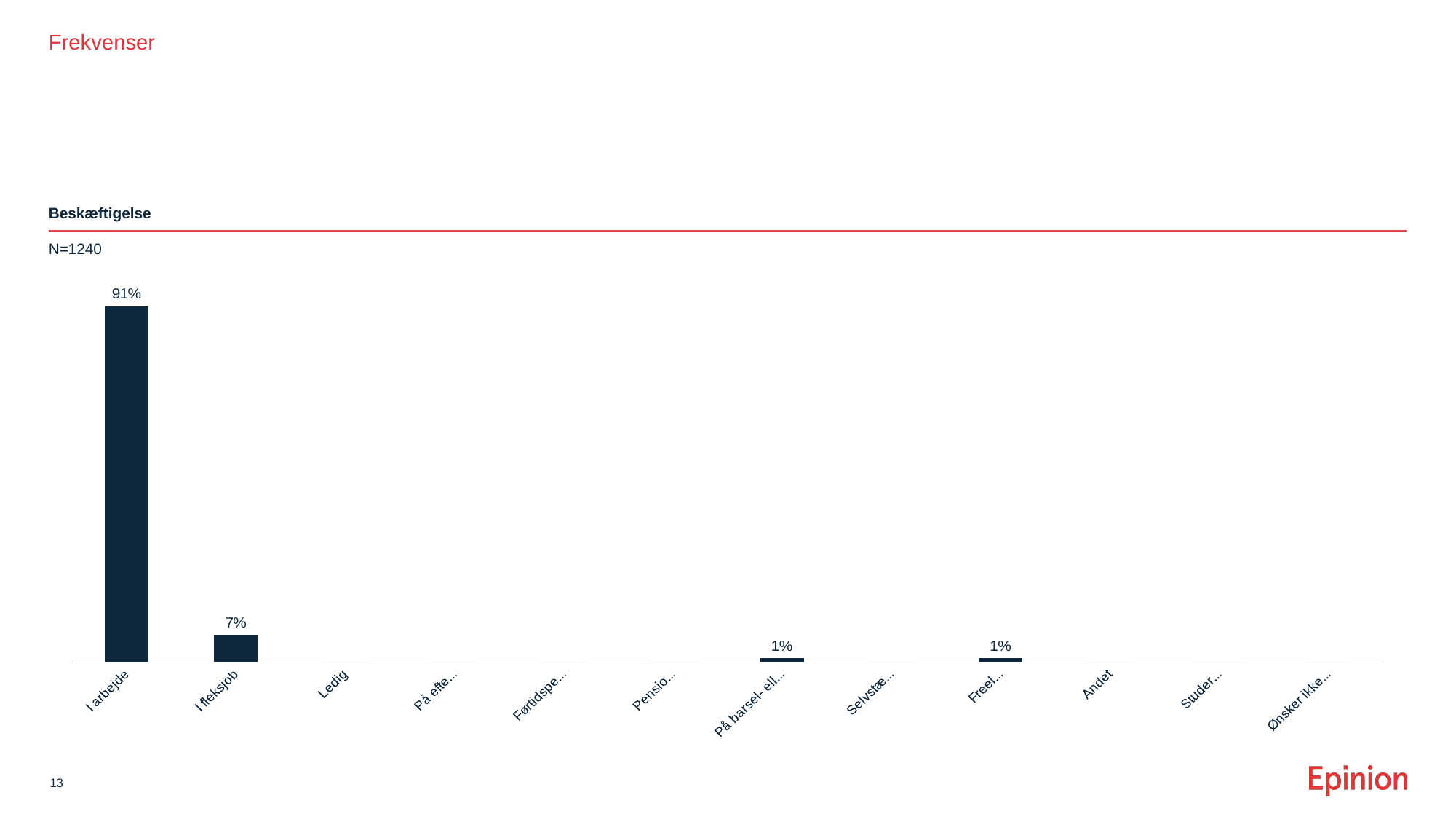
What is the difference between the values for 'I arbejde' and 'I fleksjob'? 84 percentage points What kind of chart is shown on the slide? Bar chart How many categories are shown on the x axis? 12 What is the value for 'I fleksjob'? 7% What is the title of the chart? Beskæftigelse What sample size (N) is stated for the chart? N=1240 How many bars are labelled with a value of 1%? 2 Which is larger, the value for 'I arbejde' or the value for 'I fleksjob'? I arbejde Which category has the highest value? I arbejde What is the value for 'I arbejde'? 91%